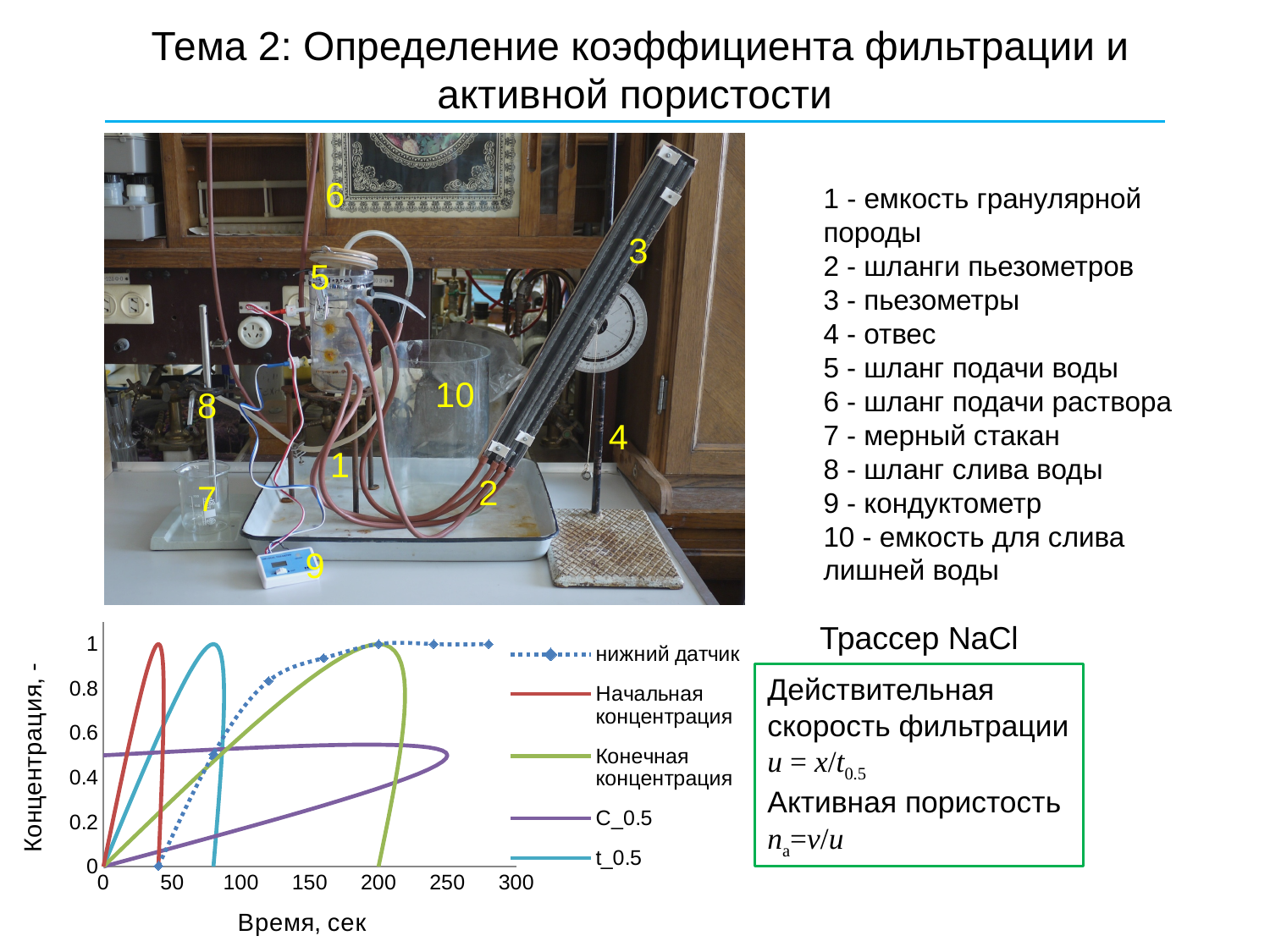
Is the value of 'нижний датчик' at 120 sec greater or less than 0.6? greater What is the largest value shown on the x axis of the chart? 300 How many series does the legend of the chart list? 5 Is the value of 'нижний датчик' at 40 sec greater or less than 0.2? less Is the peak value of the series 'Конечная концентрация' greater or less than 0.8? greater Does the value of the series 'нижний датчик' rise or fall as time increases along the x axis? rise What kind of chart is shown at the bottom left of the slide? line chart What is the title of the x axis of the chart? Время, сек What is the title of the y axis of the chart? Концентрация, - Which series reaches its peak earlier in time: 'Начальная концентрация' or 'Конечная концентрация'? Начальная концентрация